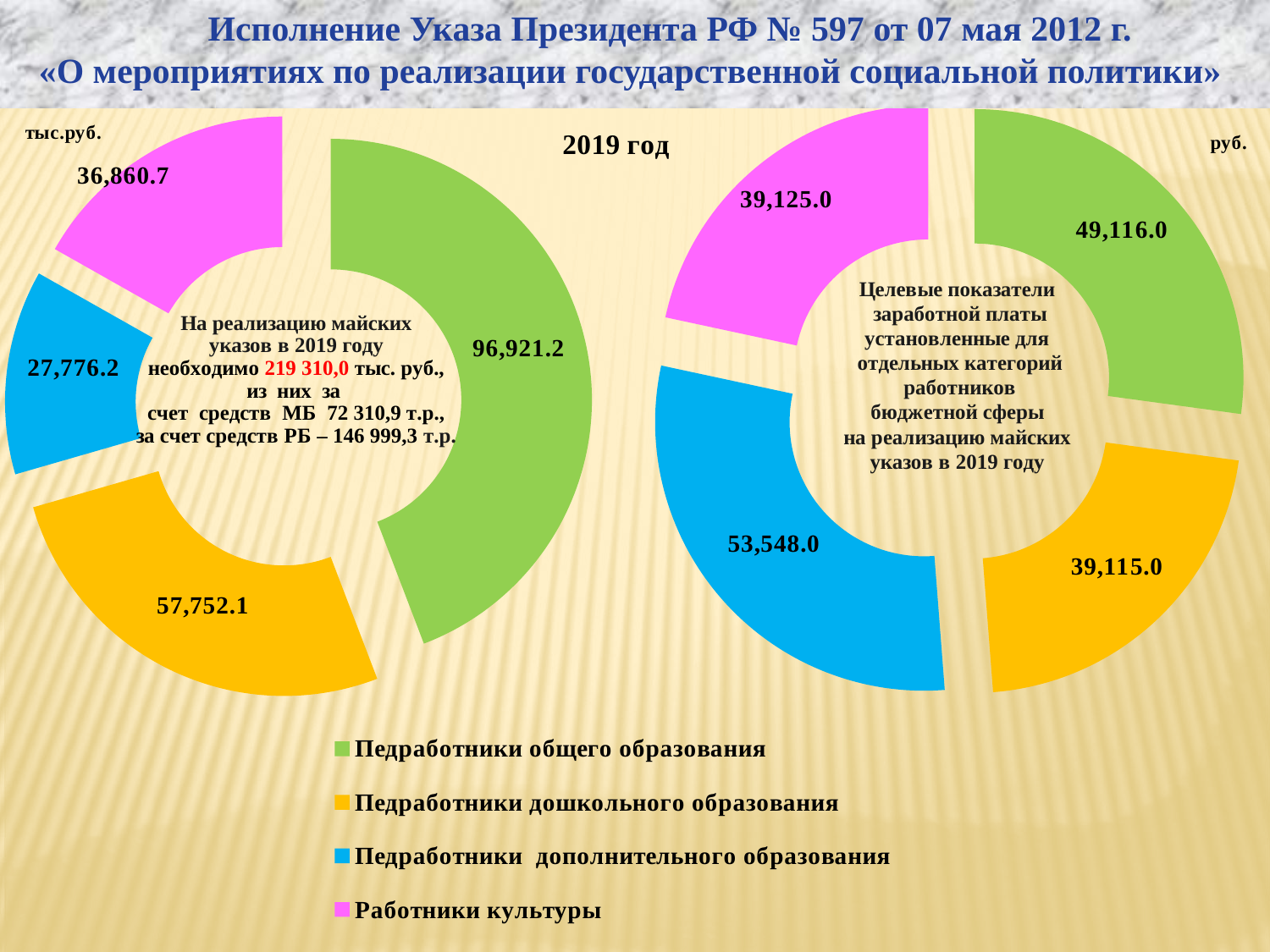
In the left chart (тыс.руб.), what is the difference between Педработники общего образования and Педработники дошкольного образования? 39,169.1 In the right chart (руб.), what is the value for Педработники дополнительного образования? 53,548.0 In the right chart (руб.), what is the value for Педработники дошкольного образования? 39,115.0 In the left chart (тыс.руб.), which is larger: Работники культуры or Педработники дополнительного образования? Работники культуры What type of chart is used on this slide? Doughnut (pie) chart In the right chart (руб.), which category has the largest value? Педработники дополнительного образования How many categories does the legend list? 4 In the left chart (тыс.руб.), which category has the smallest value? Педработники дополнительного образования In the left chart (тыс.руб.), what is the value for Педработники общего образования? 96,921.2 In the right chart (руб.), what is the difference between Педработники дополнительного образования and Педработники общего образования? 4,432.0 In the left chart (тыс.руб.), what is the value for Работники культуры? 36,860.7 In the left chart (тыс.руб.), which category has the largest value? Педработники общего образования